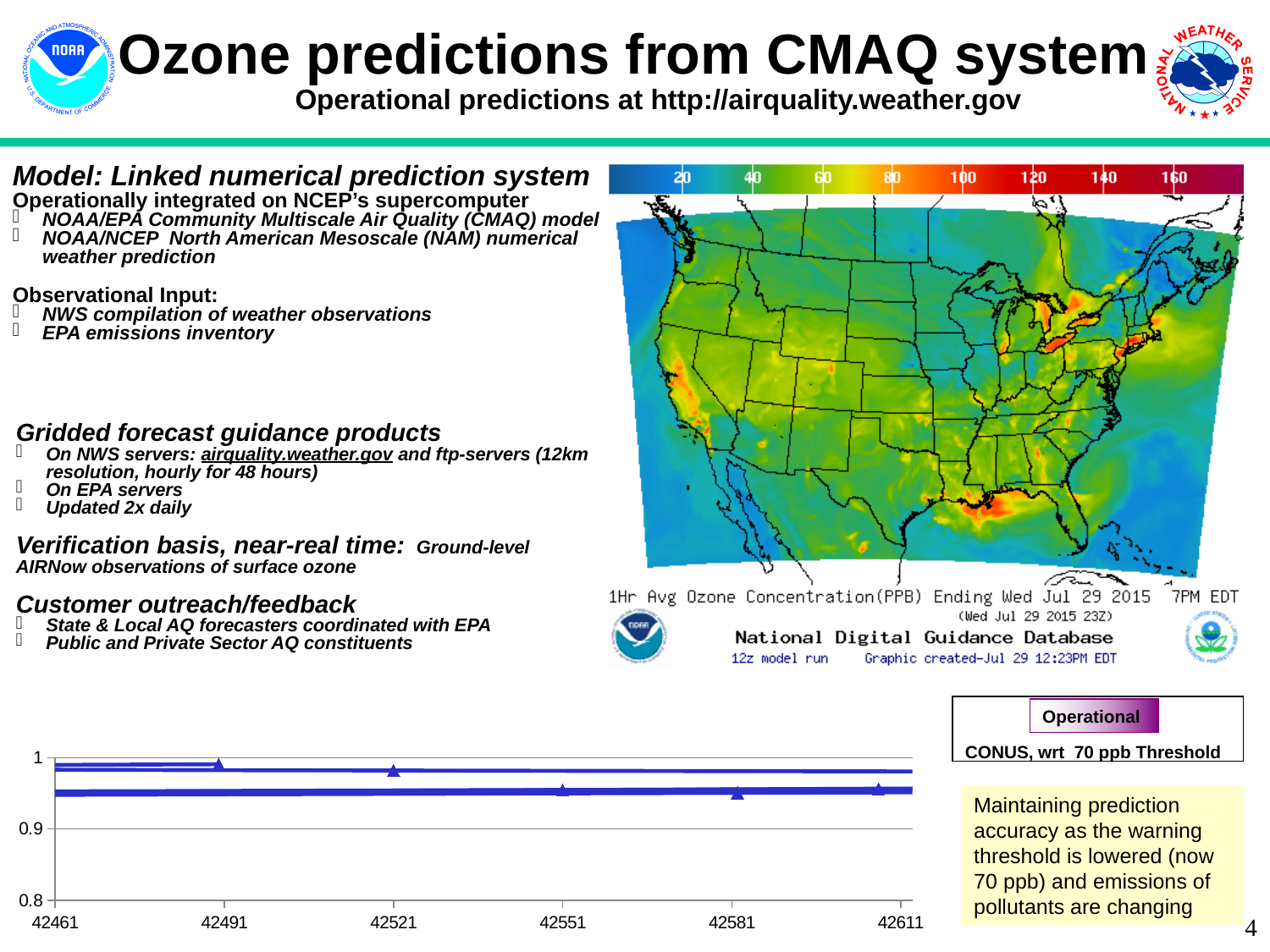
What kind of chart is shown at the bottom of the slide? line chart How many triangle markers are plotted on the bottom chart? 5 What is the first tick label on the x axis of the bottom chart? 42461 What label appears under the legend of the bottom chart? CONUS, wrt 70 ppb Threshold On the bottom chart, near which x-axis value is the highest triangle marker? 42491 On the bottom chart, which triangle marker is higher: the one near 42491 or the one near 42581? 42491 Do the triangle markers on the bottom chart generally rise or fall from left to right? fall Is the value of the triangle marker near 42491 on the bottom chart greater or less than 0.9? greater Is the value of the triangle marker near 42581 on the bottom chart greater or less than 0.9? greater How many tick labels are shown on the x axis of the bottom chart? 6